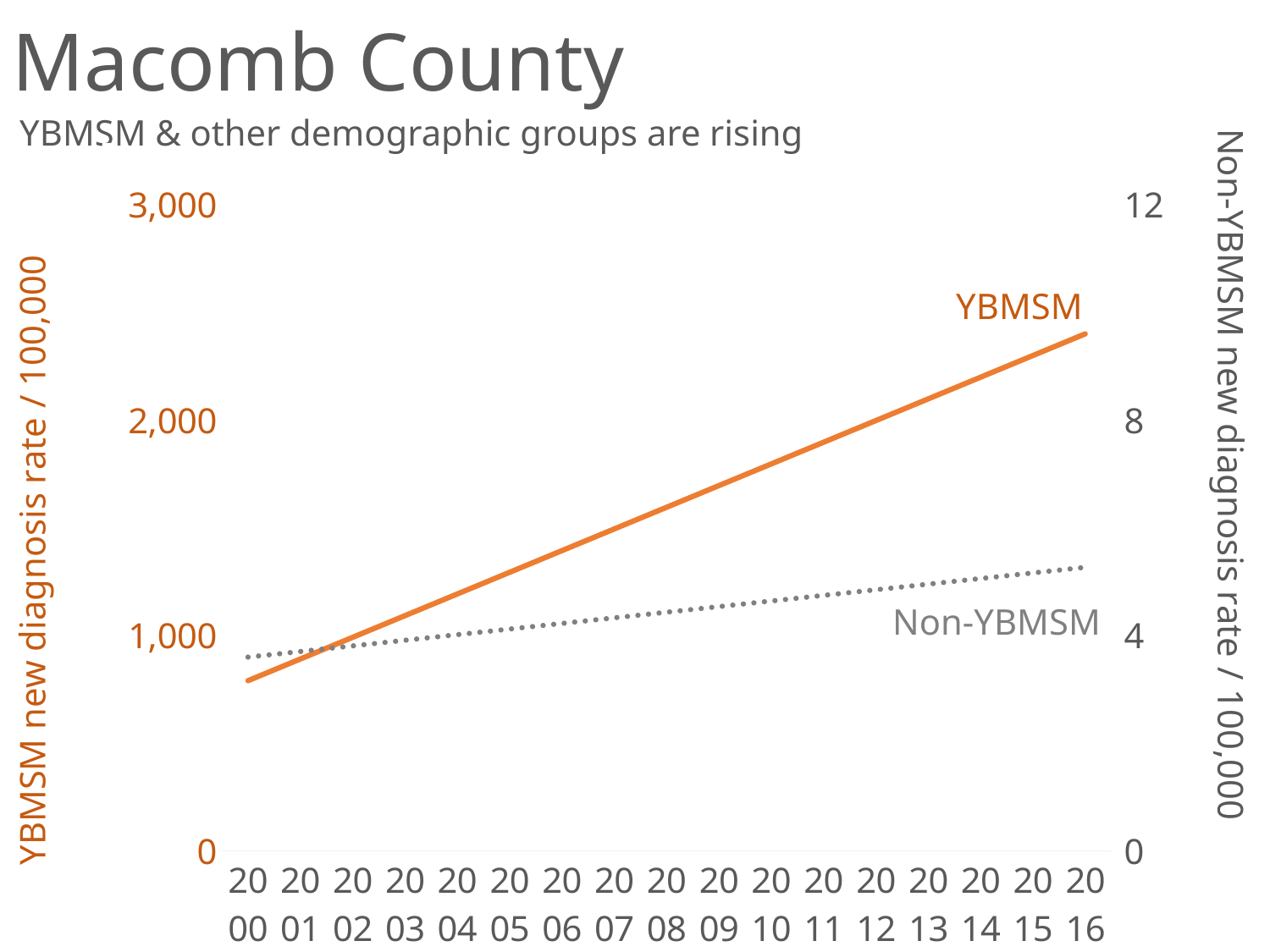
How many series are plotted on the chart? 2 Is the YBMSM value for 2000 greater or less than 1,000? less What kind of chart is shown on the slide? line chart In which year is the YBMSM new diagnosis rate lowest? 2000 What is the title of the slide? Macomb County Is the YBMSM value for 2016 greater or less than 2,000? greater How many years are shown along the x axis? 17 In which year is the YBMSM new diagnosis rate highest? 2016 Does the YBMSM new diagnosis rate rise or fall from 2000 to 2016? rise Is the Non-YBMSM value for 2016 greater or less than 4? greater What is the label of the right-hand vertical axis? Non-YBMSM new diagnosis rate / 100,000 Does the Non-YBMSM new diagnosis rate rise or fall from 2000 to 2016? rise